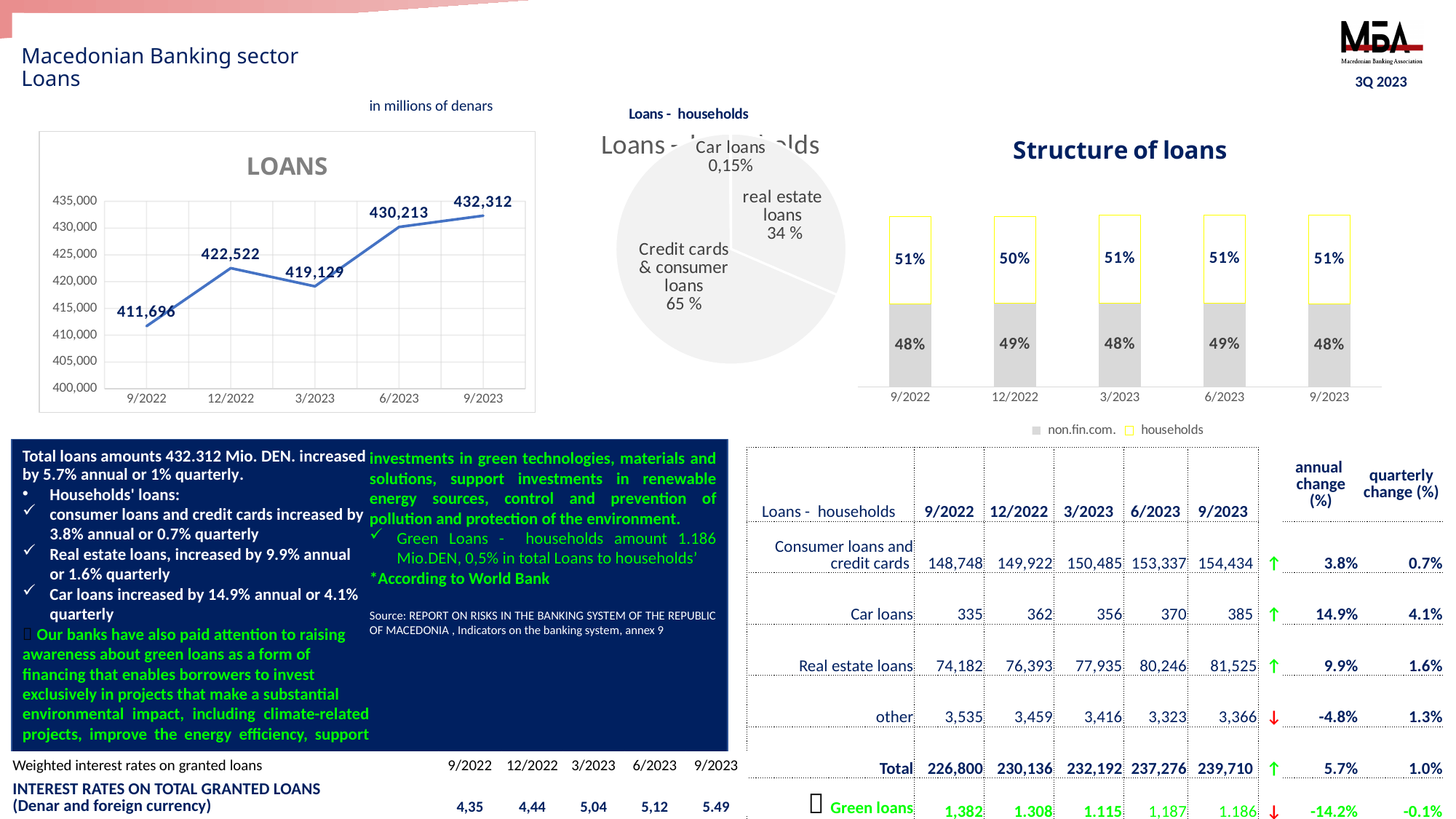
How many series does the legend of the Structure of loans chart list? 2 How many data points are plotted in the LOANS line chart? 5 In the LOANS line chart, what is the value for 9/2022? 411,696 What kind of chart is the LOANS chart? line chart In the LOANS line chart, what is the difference between the values for 9/2023 and 9/2022? 20,616 In the LOANS line chart, what is the value for 9/2023? 432,312 In the LOANS line chart, which period has the lowest value? 9/2022 In the LOANS line chart, which is larger: the value for 12/2022 or the value for 3/2023? 12/2022 In the LOANS line chart, which period has the highest value? 9/2023 In the Loans - households pie chart, what is the share of car loans? 0,15% In the Loans - households pie chart, what share do real estate loans have? 34 % In the Structure of loans chart, what is the households share for 12/2022? 50%